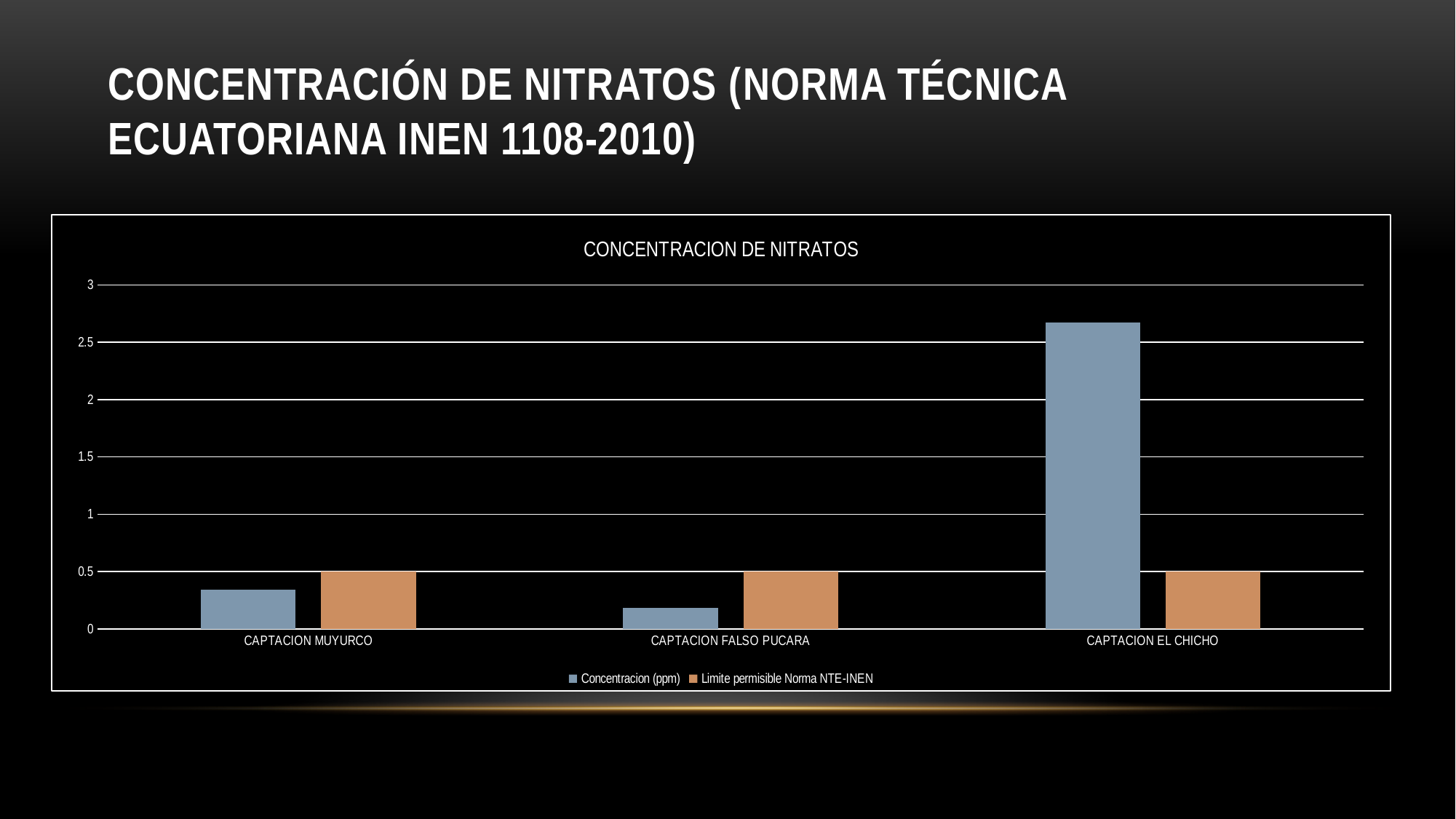
What is the value of Limite permisible Norma NTE-INEN for CAPTACION EL CHICHO? 0.5 What is the value of Limite permisible Norma NTE-INEN for CAPTACION MUYURCO? 0.5 How many series does the chart legend list? 2 What is the title of the chart? CONCENTRACION DE NITRATOS Which captacion has the lowest Concentracion (ppm)? CAPTACION FALSO PUCARA Is the Concentracion (ppm) for CAPTACION EL CHICHO greater or less than 2.5? greater How many captaciones (categories) are shown on the x axis of the chart? 3 Is the Concentracion (ppm) for CAPTACION FALSO PUCARA greater or less than 0.5? less What type of chart is shown on the slide? Bar chart Which captacion has the highest Concentracion (ppm)? CAPTACION EL CHICHO For CAPTACION EL CHICHO, which is larger: the Concentracion (ppm) or the Limite permisible Norma NTE-INEN? Concentracion (ppm) For CAPTACION MUYURCO, which is larger: the Concentracion (ppm) or the Limite permisible Norma NTE-INEN? Limite permisible Norma NTE-INEN